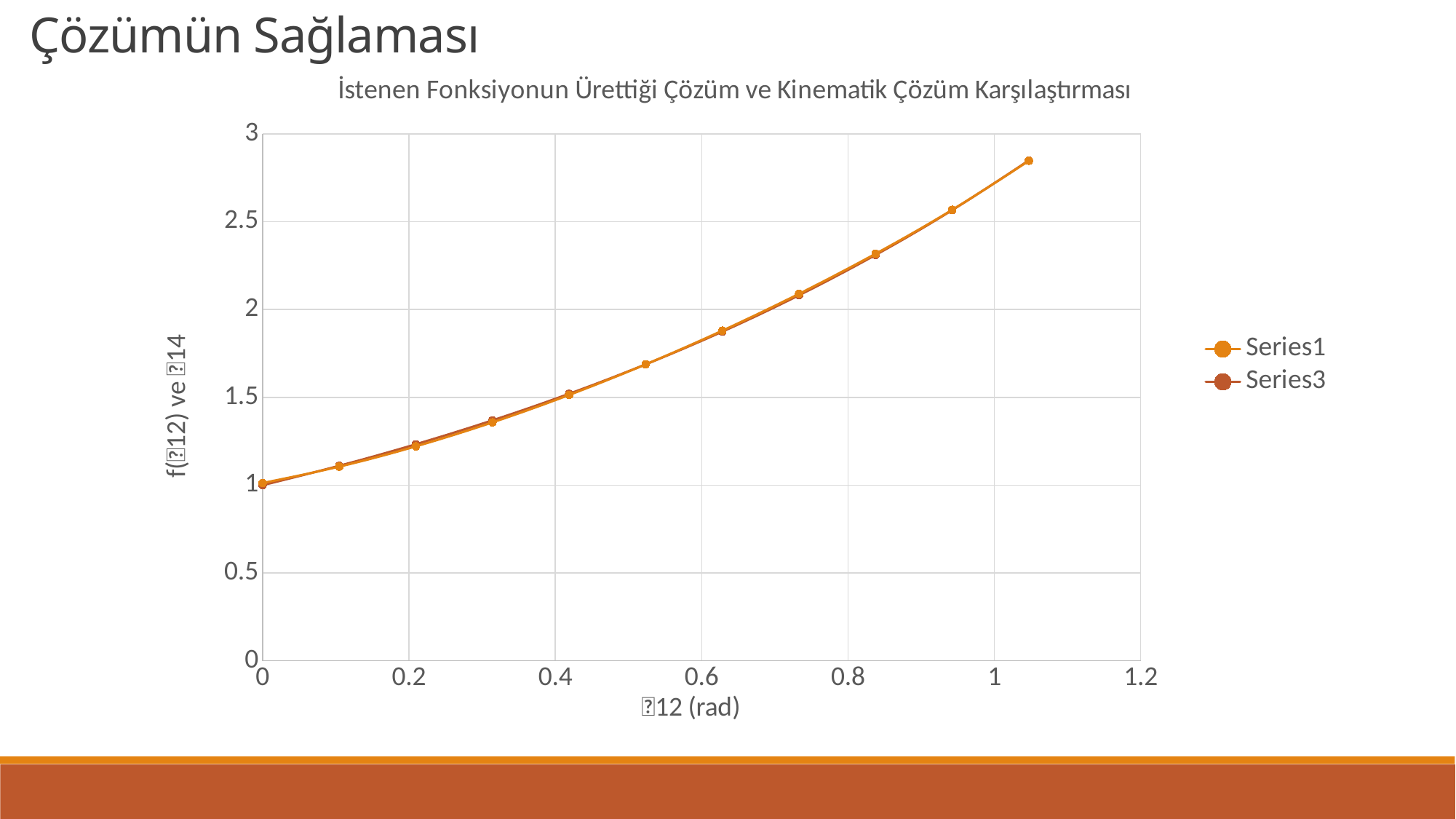
What is the title of the chart? İstenen Fonksiyonun Ürettiği Çözüm ve Kinematik Çözüm Karşılaştırması What kind of chart is shown on the slide? Line chart Is the value of the plotted point just above x = 0.5 greater or less than 2? less Is the value of the plotted point just above x = 0.8 greater or less than 2? greater Is the value of the plotted point just above x = 0.6 greater or less than 1.5? greater Which plotted point has the highest value, the leftmost or the rightmost? The rightmost What are the names of the series listed in the legend? Series1 and Series3 Do the plotted values rise or fall as the x-axis value increases? Rise How many series does the legend list? 2 How many data points are plotted for Series1? 11